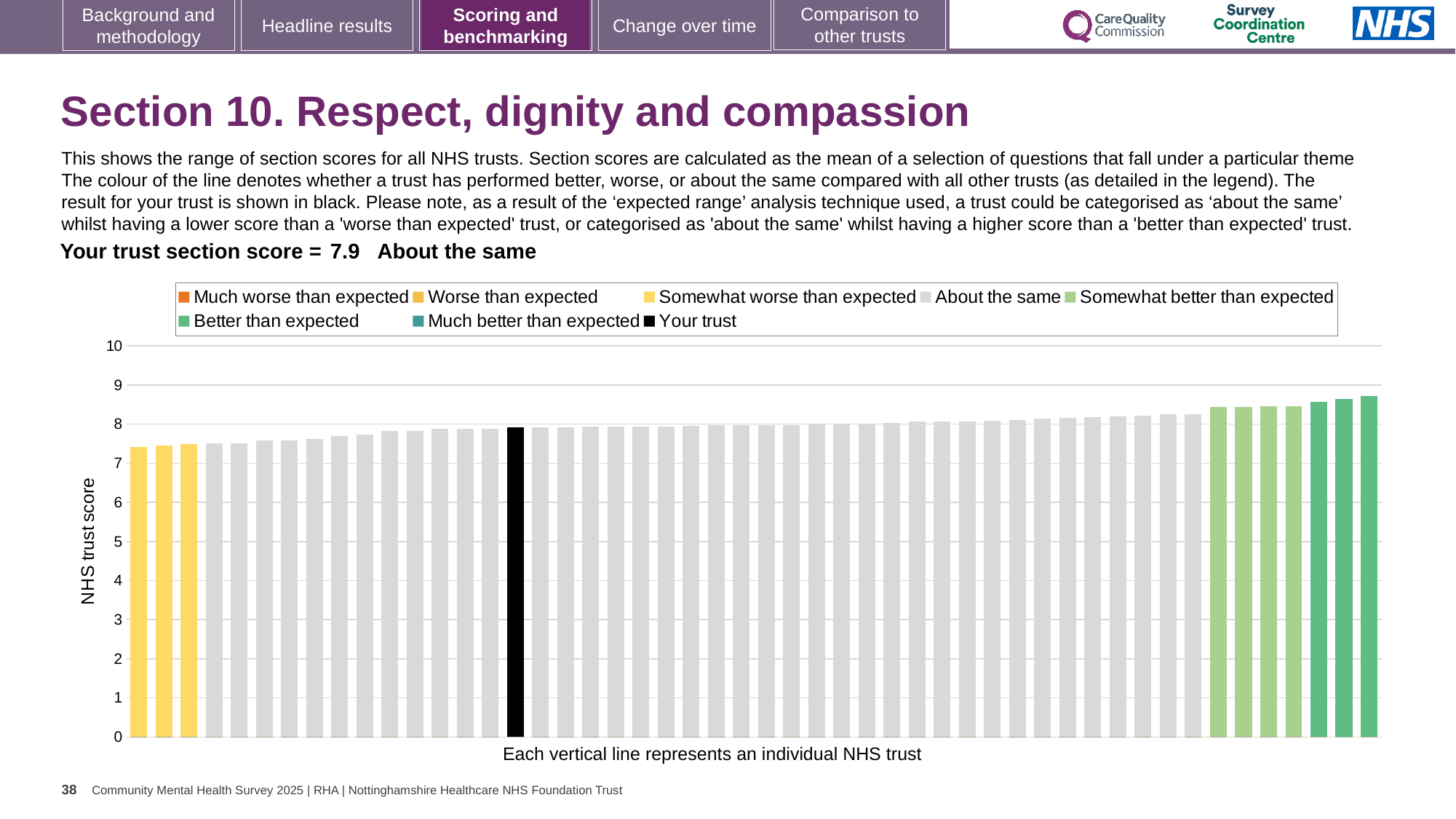
Is the value of the shortest bar greater or less than 7? greater Do the bar values rise or fall from left to right along the x axis? rise How many entries does the chart legend list? 8 What is the label on the vertical axis of the chart? NHS trust score What does each vertical line in the chart represent, according to the x-axis label? an individual NHS trust How many green bars are there at the right of the chart? 7 Which category is your trust placed in for this section? About the same What kind of chart is shown on the slide? bar chart Is the value of the tallest bar greater or less than 9? less What is the section score for your trust? 7.9 How many yellow bars are there at the left of the chart? 3 Is the value of the black bar (your trust) greater or less than 5? greater